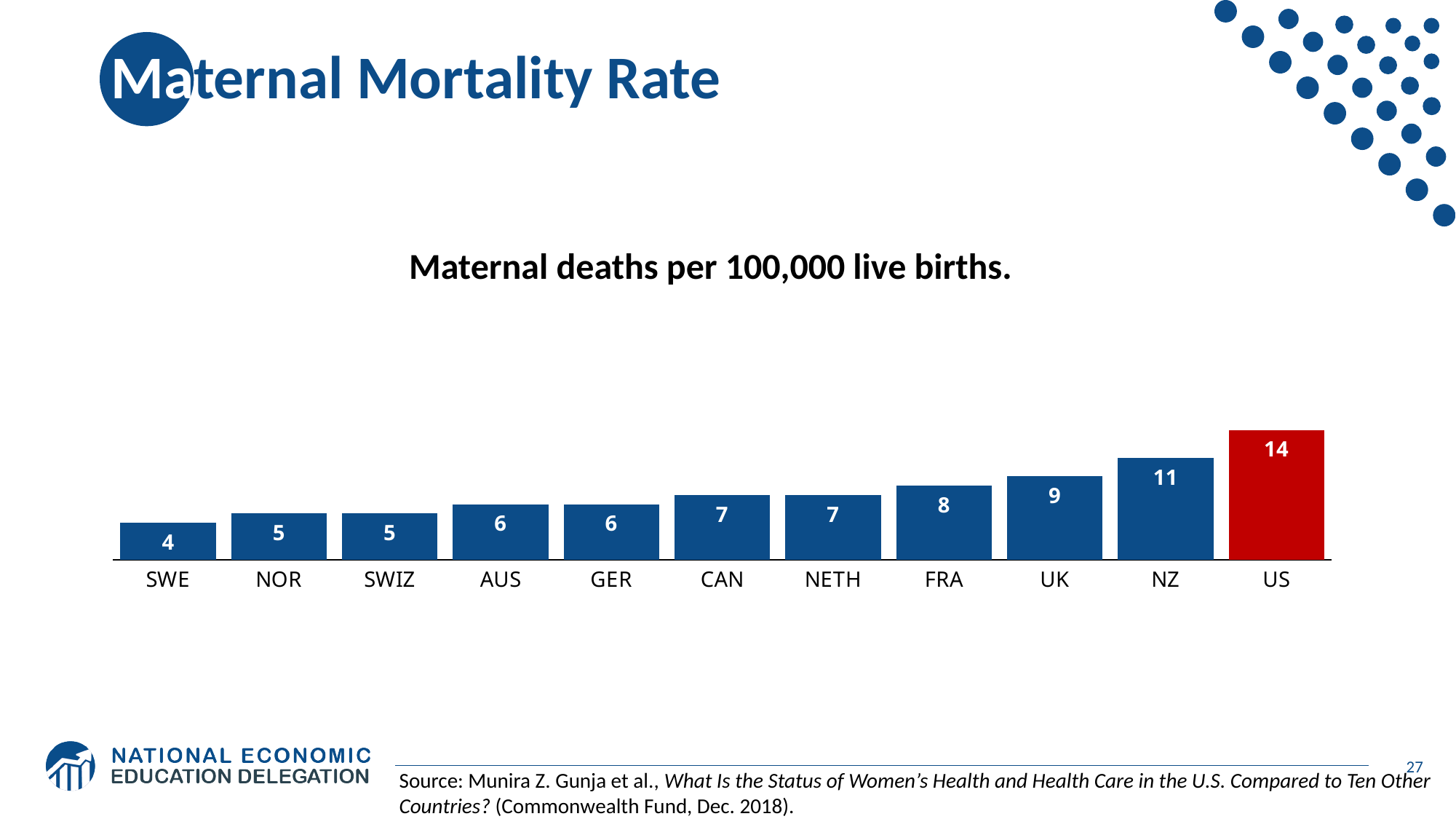
Which bar is coloured red rather than blue? US Which country has the highest maternal mortality rate on the chart? US What value is shown for SWE? 4 What is the maternal mortality rate shown for the US? 14 What is the difference between the values for the US and NZ? 3 What value is shown for NZ? 11 How many countries are shown on the chart? 11 Do the values rise or fall moving from left to right along the x axis? rise What is the difference between the values for the UK and SWE? 5 Which has a higher value, FRA or CAN? FRA Which country has the lowest maternal mortality rate on the chart? SWE What kind of chart is shown on the slide? bar chart